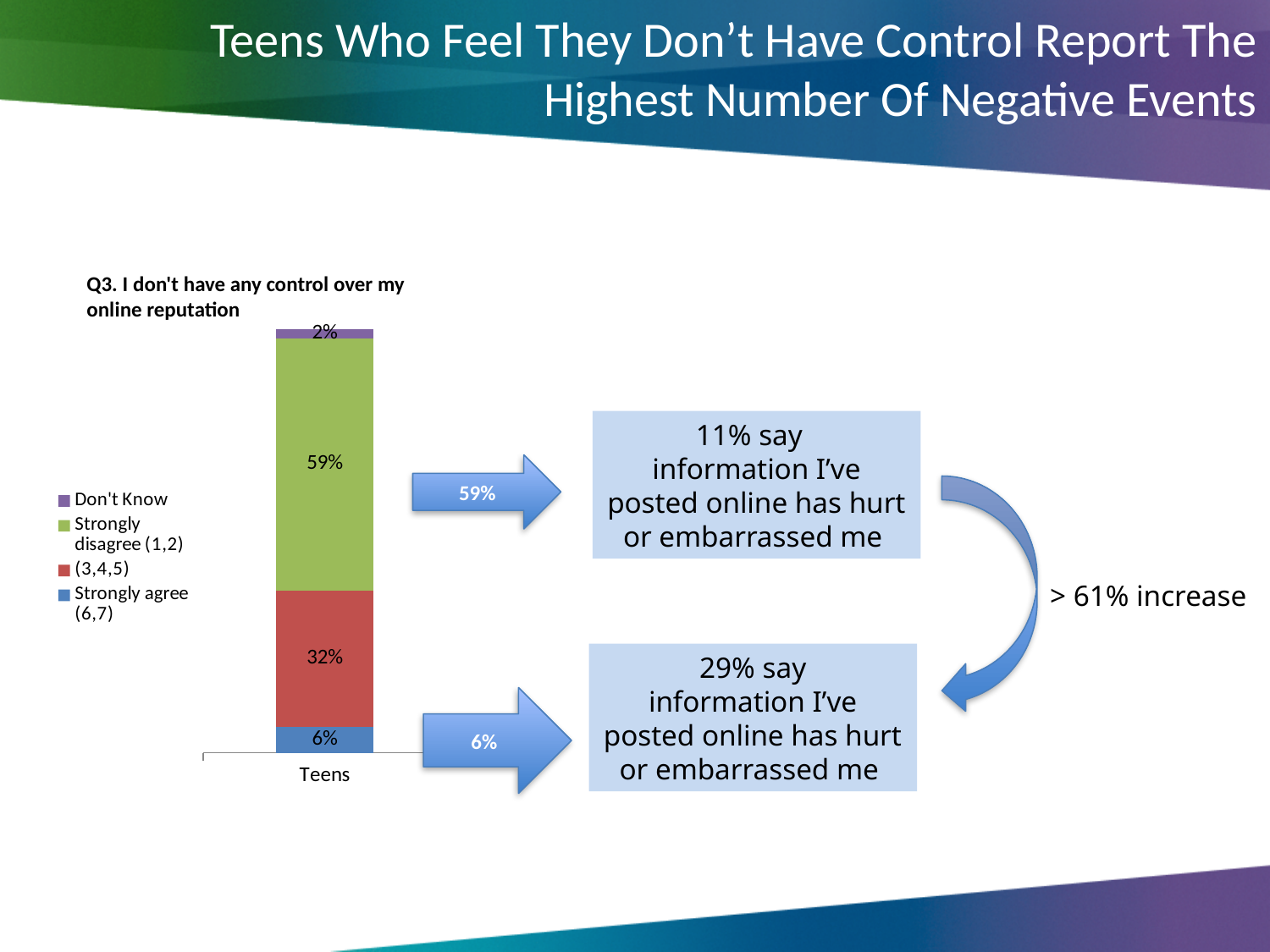
What percentage of teens fall in the (3,4,5) group in the chart? 32% How many categories are shown on the x axis of the chart? 1 What percentage of teens answered "Don't Know" in the chart? 2% What percentage of teens strongly agree (6,7) with the statement "I don't have any control over my online reputation"? 6% What percentage of teens strongly disagree (1,2) with the statement "I don't have any control over my online reputation"? 59% Which response group has the smallest share in the Teens bar? Don't Know What is the title of the chart? Q3. I don't have any control over my online reputation Which is larger in the Teens bar: the (3,4,5) share or the Strongly agree (6,7) share? (3,4,5) What is the difference between the Strongly disagree (1,2) share and the (3,4,5) share? 27% Which response group has the largest share in the Teens bar? Strongly disagree (1,2) How many series does the chart legend list? 4 What type of chart is shown on the slide? stacked bar chart